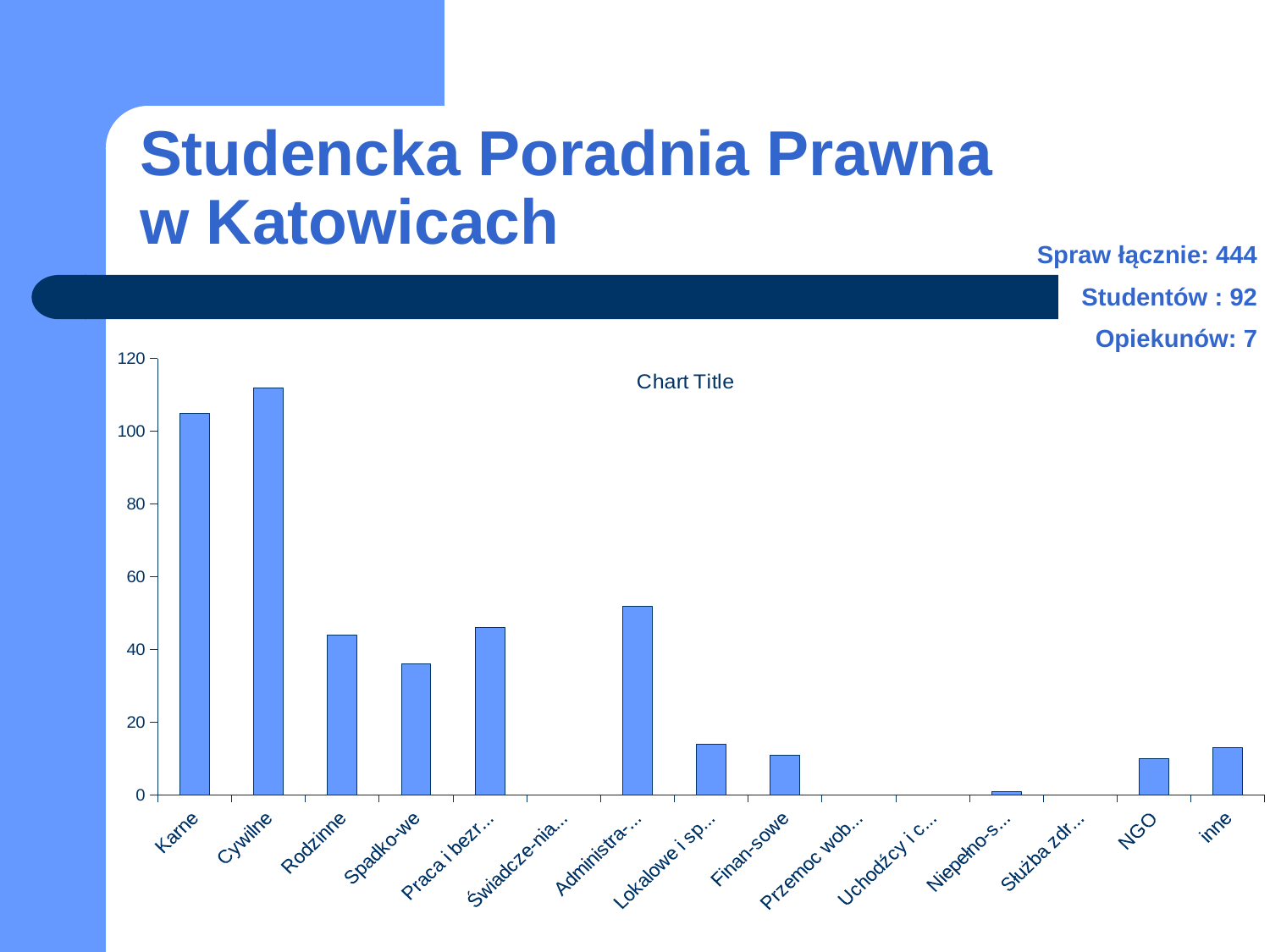
Is the value for Cywilne greater or less than 100? greater What kind of chart is shown on the slide? bar chart Is the value for Rodzinne greater or less than 40? greater Is the value for Spadko-we greater or less than 40? less How many categories are shown on the x axis of the chart? 15 Which category has the highest bar in the chart? Cywilne Which is larger, the value for Karne or the value for Rodzinne? Karne Which is larger, the value for Rodzinne or the value for Spadko-we? Rodzinne What is the title shown on the chart? Chart Title